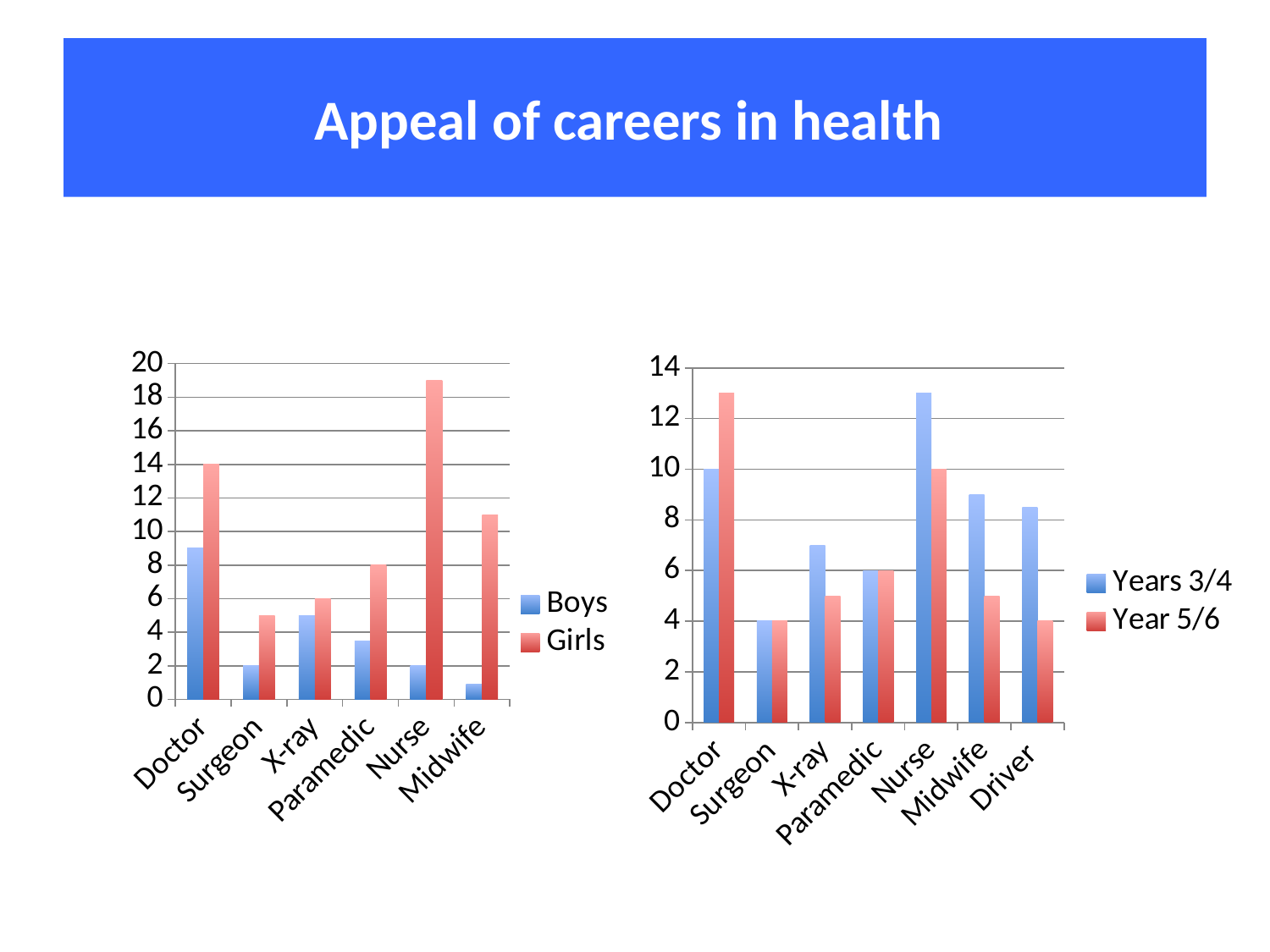
In the left chart, what is the value for Girls for Doctor? 14 In the left chart, which category has the lowest value for Boys? Midwife In the right chart, what is the value for Years 3/4 for Doctor? 10 In the left chart, is the value for Girls for Nurse greater or less than 18? greater In the right chart, which category has the highest value for Years 3/4? Nurse In the right chart, which is larger for Driver, Years 3/4 or Year 5/6? Years 3/4 In the right chart, how many career categories are shown on the x axis? 7 What kind of chart is the left chart on the slide? bar chart In the right chart, is the value for Years 3/4 for Nurse greater or less than 12? greater In the left chart, which is larger for Paramedic, Boys or Girls? Girls In the left chart, how many series does the legend list? 2 In the left chart, which category has the highest value for Girls? Nurse